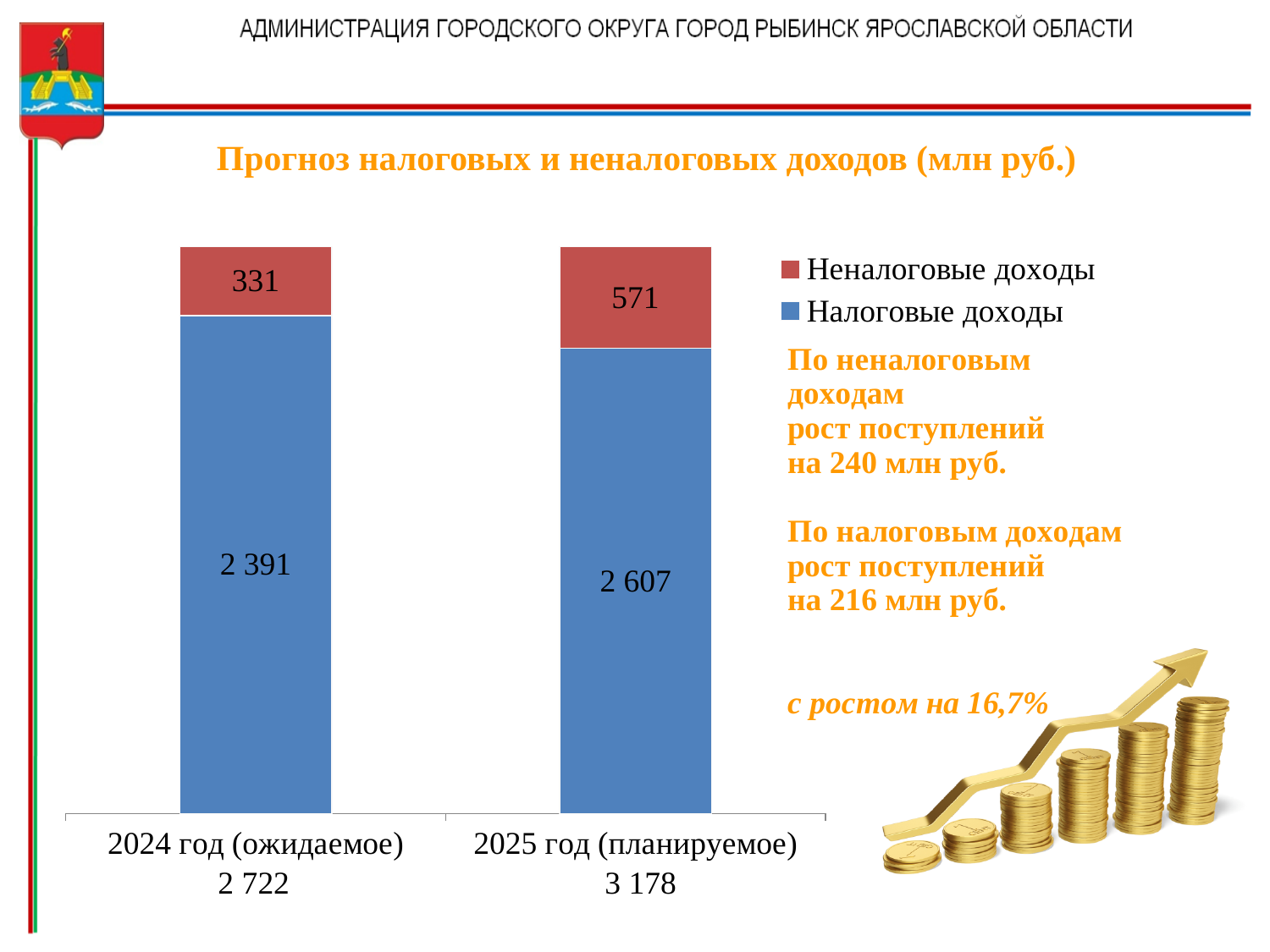
Which year has the higher value of Неналоговые доходы? 2025 год (планируемое) What is the total of the stacked bar for 2025 год (планируемое)? 3 178 What is the difference between Налоговые доходы in 2025 год (планируемое) and 2024 год (ожидаемое)? 216 What kind of chart is shown on the slide? Stacked bar chart What is the value of Неналоговые доходы for 2025 год (планируемое)? 571 What is the difference between Неналоговые доходы in 2025 год (планируемое) and 2024 год (ожидаемое)? 240 What is the value of Налоговые доходы for 2024 год (ожидаемое)? 2 391 What is the total of the stacked bar for 2024 год (ожидаемое)? 2 722 What is the value of Налоговые доходы for 2025 год (планируемое)? 2 607 What is the title of the chart? Прогноз налоговых и неналоговых доходов (млн руб.) What is the value of Неналоговые доходы for 2024 год (ожидаемое)? 331 How many series does the legend list? 2